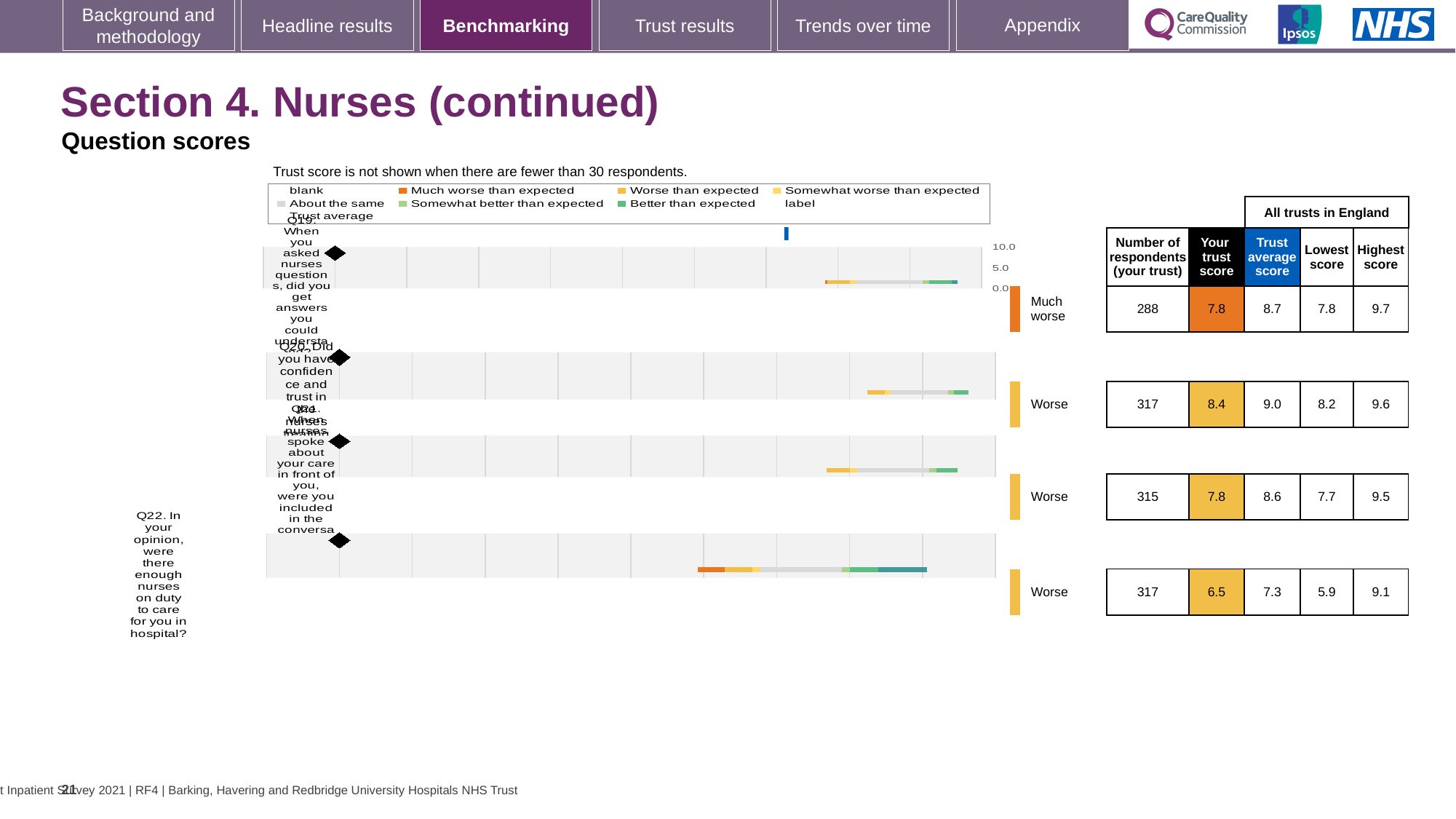
Which question has the highest 'Your trust score'? Q20 What benchmark category label is shown next to Q19? Much worse What kind of chart is used to show the question scores on this slide? bar chart For Q22, what is the difference between the trust average score (7.3) and your trust score (6.5)? 0.8 What is the highest score across all trusts in England for Q19? 9.7 What colour does the legend use for 'Much worse than expected'? Orange What is the lowest score across all trusts in England for Q22? 5.9 Which question has the lowest 'Your trust score'? Q22 How many respondents does the table show for Q19? 288 What is the 'Your trust score' for Q22 (enough nurses on duty)? 6.5 How many questions (categories) are plotted in the chart? 4 For Q19, which is larger: your trust score or the trust average score? Trust average score